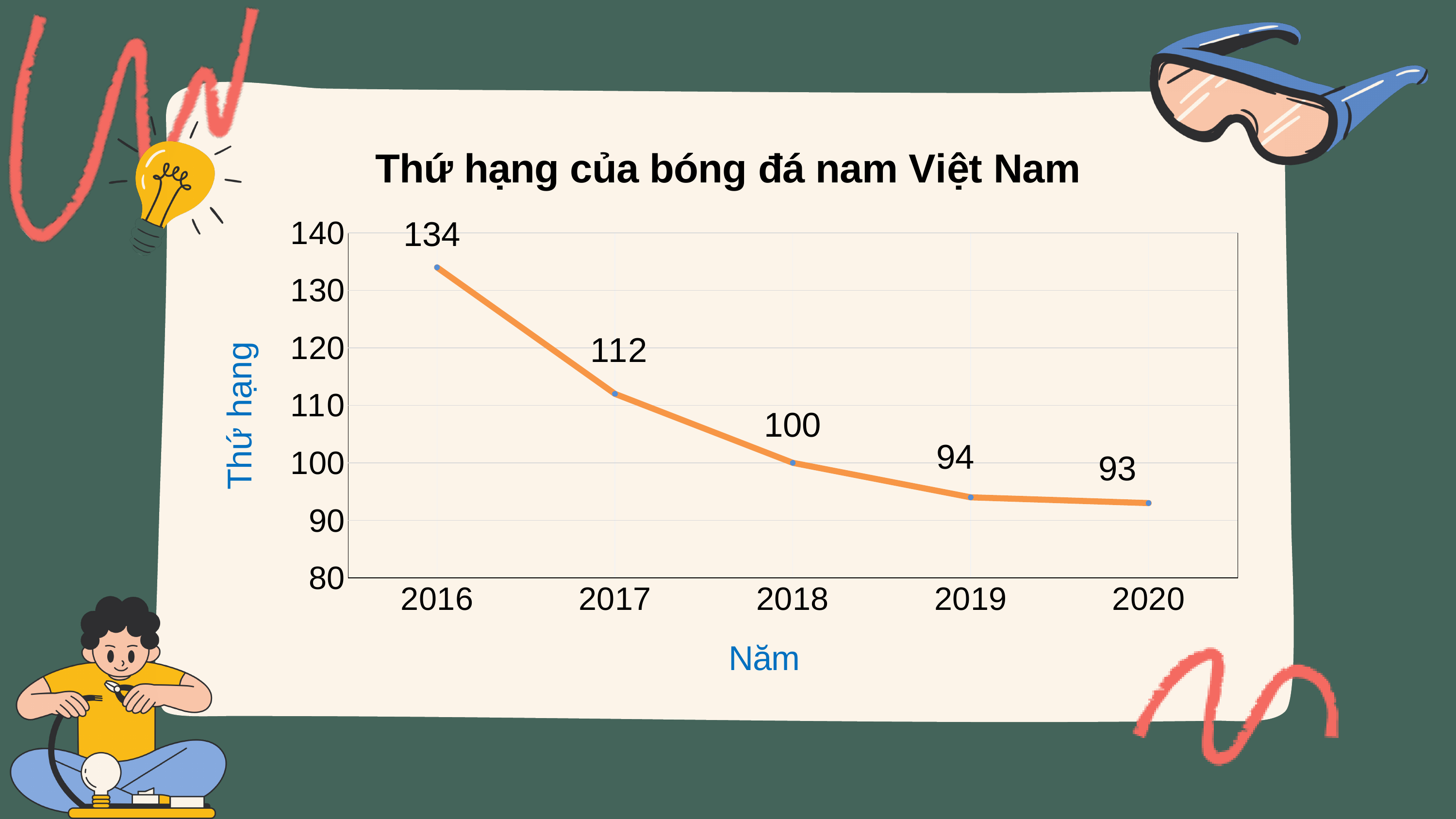
Which year has the highest plotted value? 2016 What was the ranking in 2020? 93 What is the difference between the 2018 value and the 2019 value? 6 What was the ranking of Vietnam men's football in 2016? 134 How many years are plotted on the chart? 5 Which year has the lowest plotted value? 2020 Which is larger, the value for 2017 or the value for 2019? 2017 What kind of chart is shown on the slide? line chart What was the ranking in 2018? 100 Do the values rise or fall from 2016 to 2020? fall What is the difference between the 2016 value and the 2017 value? 22 Is the value for 2017 greater or less than 110? greater